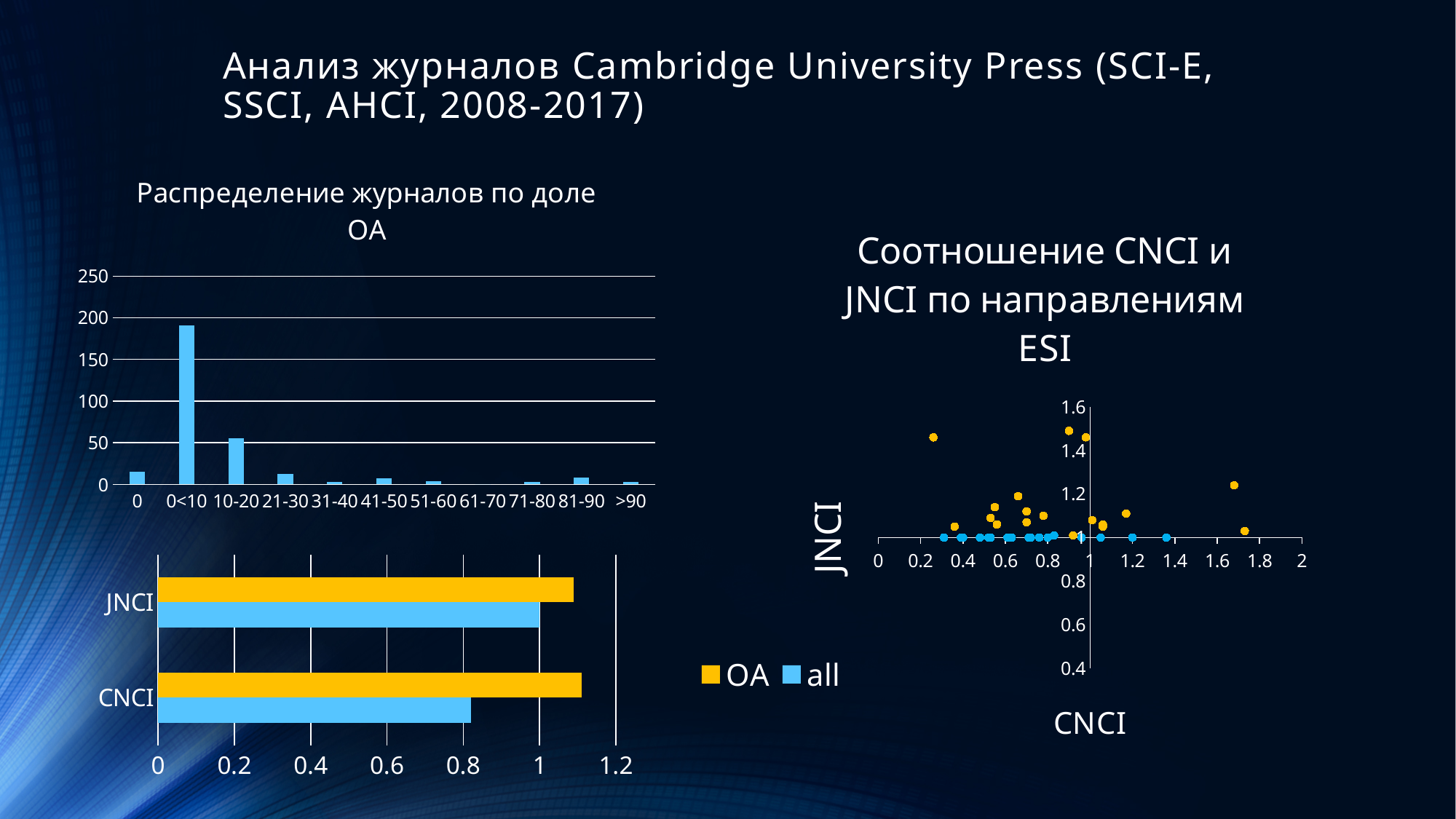
In the bottom-left horizontal bar chart, for CNCI, which series has the larger value, OA or all? OA In the bottom-left horizontal bar chart, is the OA value for CNCI greater or less than 1? greater How many categories are shown on the x axis of the top-left chart 'Распределение журналов по доле OA'? 11 In the top-left chart 'Распределение журналов по доле OA', is the value for 10-20 greater or less than 100? less In the top-left chart 'Распределение журналов по доле OA', is the value for 0<10 greater or less than 150? greater How many series does the legend of the bottom-left horizontal bar chart list? 2 What are the legend entries of the bottom-left horizontal bar chart? OA and all What kind of chart is the right-hand chart titled 'Соотношение CNCI и JNCI по направлениям ESI'? scatter chart In the top-left chart 'Распределение журналов по доле OA', which is larger, the value for 10-20 or the value for 21-30? 10-20 In the top-left chart 'Распределение журналов по доле OA', which category has the highest value? 0<10 In the right-hand chart 'Соотношение CNCI и JNCI по направлениям ESI', what are the x-axis and y-axis labels? x axis: CNCI, y axis: JNCI What kind of chart is the top-left chart titled 'Распределение журналов по доле OA'? bar chart